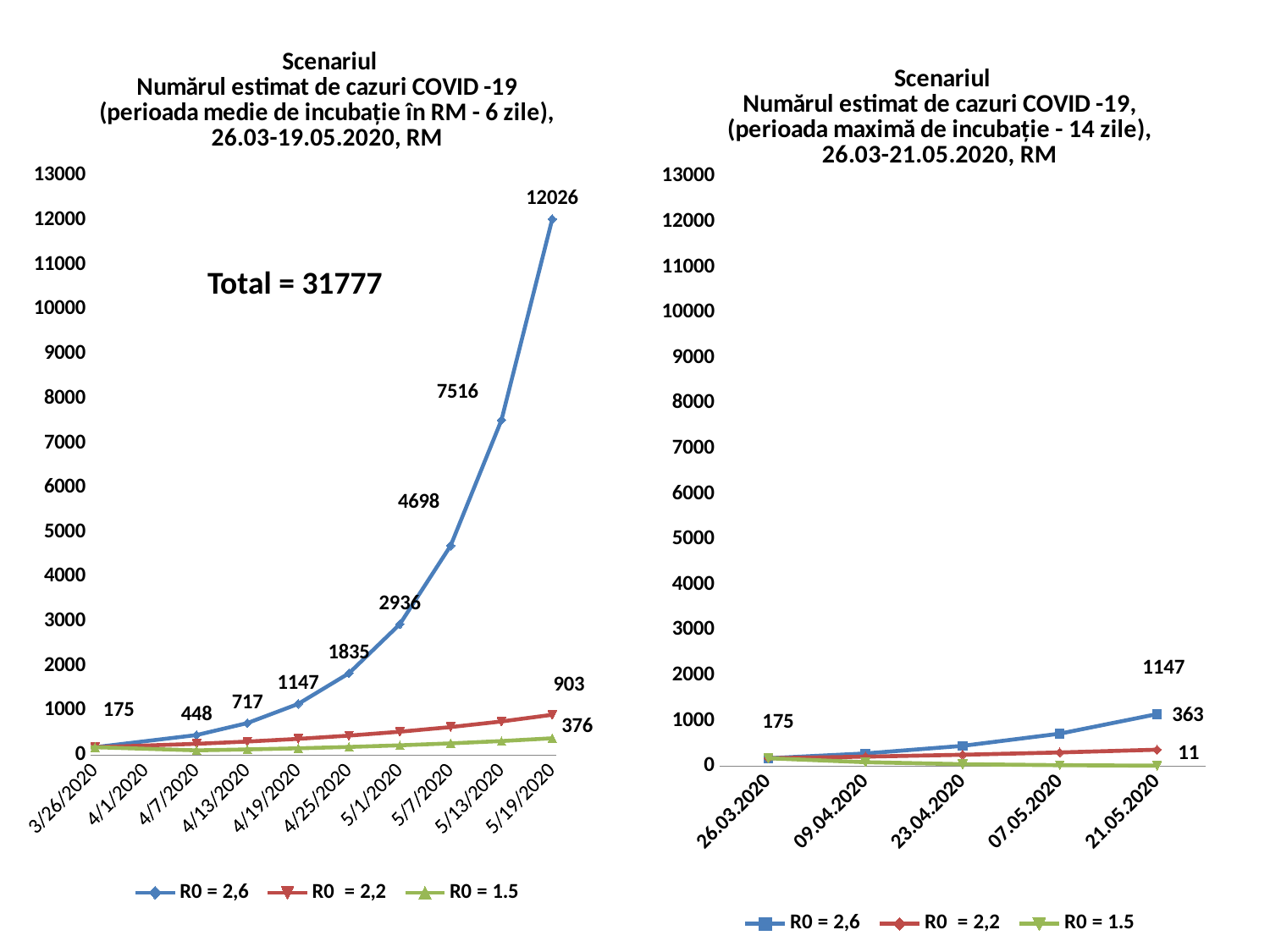
On the left chart (6-day incubation scenario), what total is printed on the chart? Total = 31777 What kind of chart is the right chart (14-day incubation scenario)? line chart On the right chart (14-day incubation scenario), what is the value of the R0 = 2,6 series on 21.05.2020? 1147 On the left chart (6-day incubation scenario), what is the difference between the R0 = 2,6 values labelled 12026 and 7516? 4510 On the left chart (6-day incubation scenario), how many series does the legend list? 3 On the left chart (6-day incubation scenario), what is the value of the R0 = 2,2 series at the last date? 903 On the left chart (6-day incubation scenario), how many dates are shown on the x axis? 10 On the right chart (14-day incubation scenario), which series has the highest value on 21.05.2020? R0 = 2,6 On the left chart (6-day incubation scenario), what is the value of the R0 = 2,6 series on 5/19/2020? 12026 On the left chart (6-day incubation scenario), what is the value of the R0 = 1.5 series at the last date? 376 On the right chart (14-day incubation scenario), does the R0 = 1.5 series rise or fall along the x axis? fall On the right chart (14-day incubation scenario), what is the value of the R0 = 1.5 series on 21.05.2020? 11